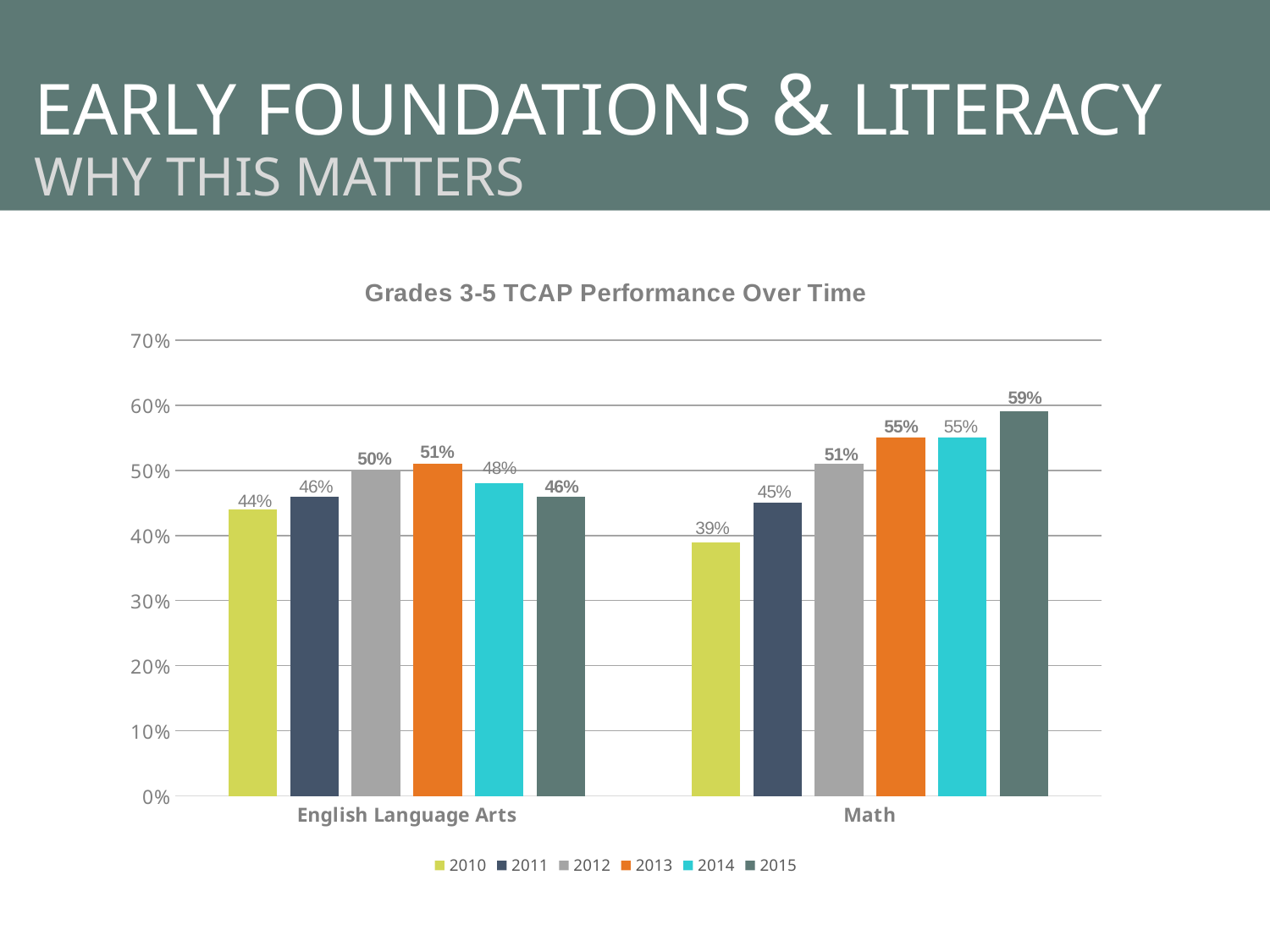
How many categories are shown on the x axis? 2 Which year has the lowest value in Math? 2010 What is the value for 2015 in Math? 59% What is the value for 2010 in English Language Arts? 44% What is the difference between the 2015 and 2010 values in Math? 20% What is the title of the chart? Grades 3-5 TCAP Performance Over Time What is the value for 2013 in English Language Arts? 51% Which year has the highest value in English Language Arts? 2013 What kind of chart is this? Bar chart How many series does the legend list? 6 What is the difference between the 2012 and 2011 values in English Language Arts? 4% Which is larger: the 2014 value for English Language Arts or the 2014 value for Math? Math